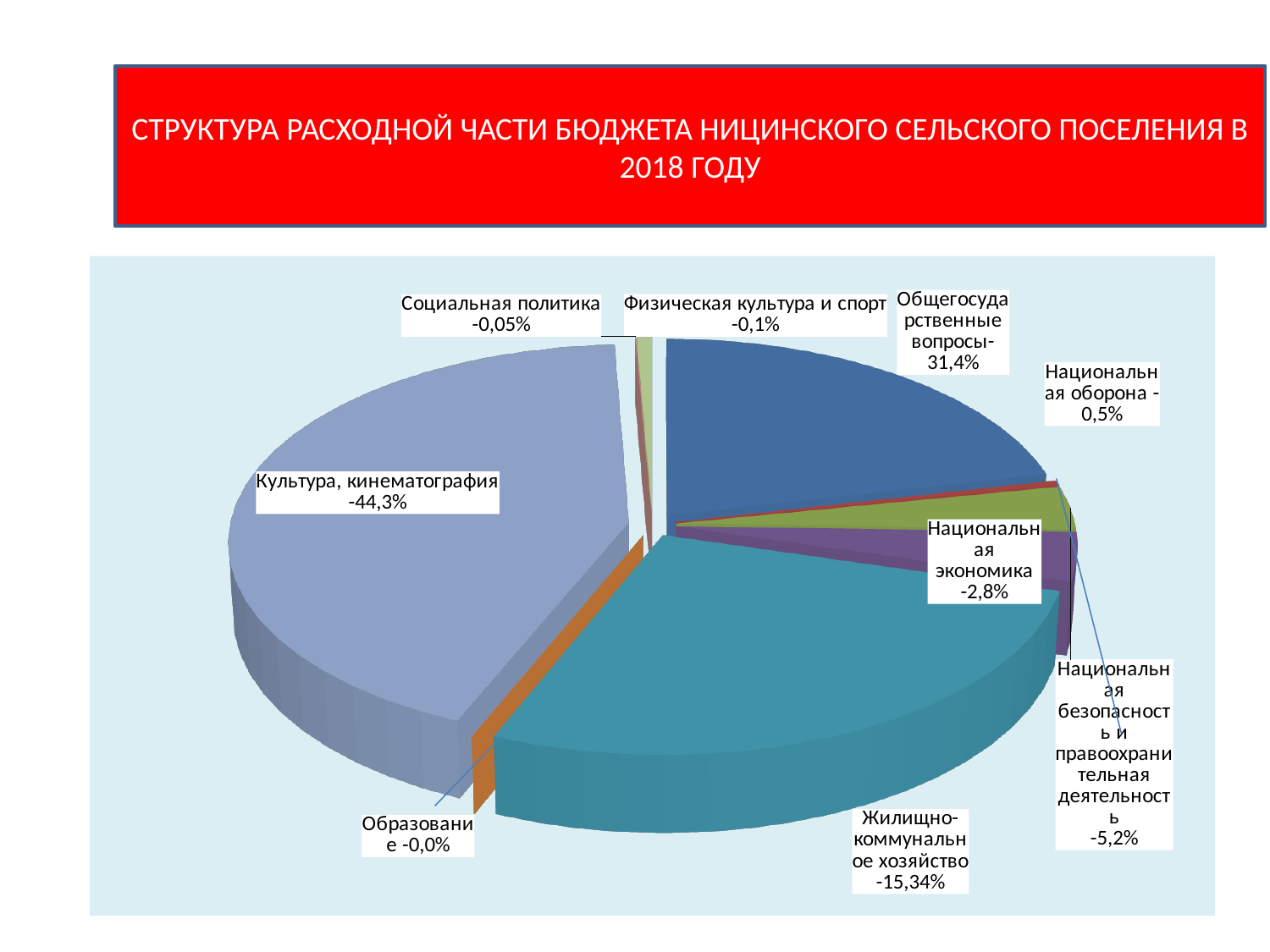
Which category has the smallest share of the pie? Образование Which year does the chart title say the budget expenditure structure refers to? 2018 What value is shown for Жилищно-коммунальное хозяйство? 15,34% What kind of chart is shown on the slide? Pie chart What value is shown for Общегосударственные вопросы? 31,4% What value is shown for Национальная оборона? 0,5% What value is shown for Национальная безопасность и правоохранительная деятельность? 5,2% What is the difference between the shares of Культура, кинематография and Общегосударственные вопросы? 12,9% What share of the budget expenditure is labelled for Культура, кинематография? 44,3% Which category has the largest share of the pie? Культура, кинематография Which is larger: the share for Национальная экономика or the share for Национальная безопасность и правоохранительная деятельность? Национальная безопасность и правоохранительная деятельность How many categories (slices) does the pie chart show? 9